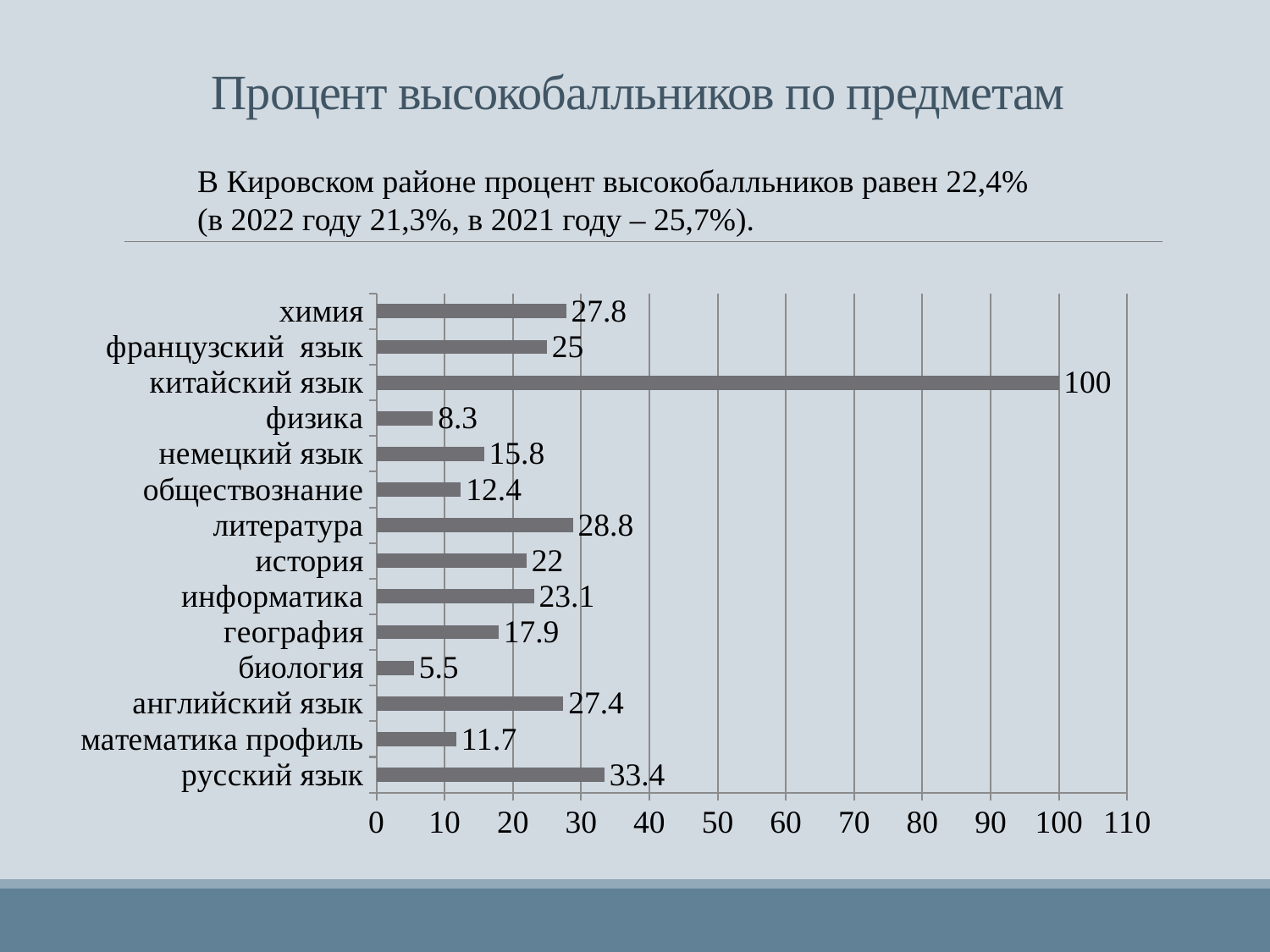
What is the value for физика? 8.3 What kind of chart is shown on the slide? bar chart What is the title of the slide? Процент высокобалльников по предметам What is the difference between the values for английский язык and биология? 21.9 Is the value for немецкий язык greater or less than 20? less What is the value for русский язык? 33.4 What is the difference between the values for литература and история? 6.8 Which subject has the highest value? китайский язык How many subjects are shown in the chart? 14 Which is larger, the value for химия or the value for французский язык? химия What is the value for информатика? 23.1 Which subject has the lowest value? биология